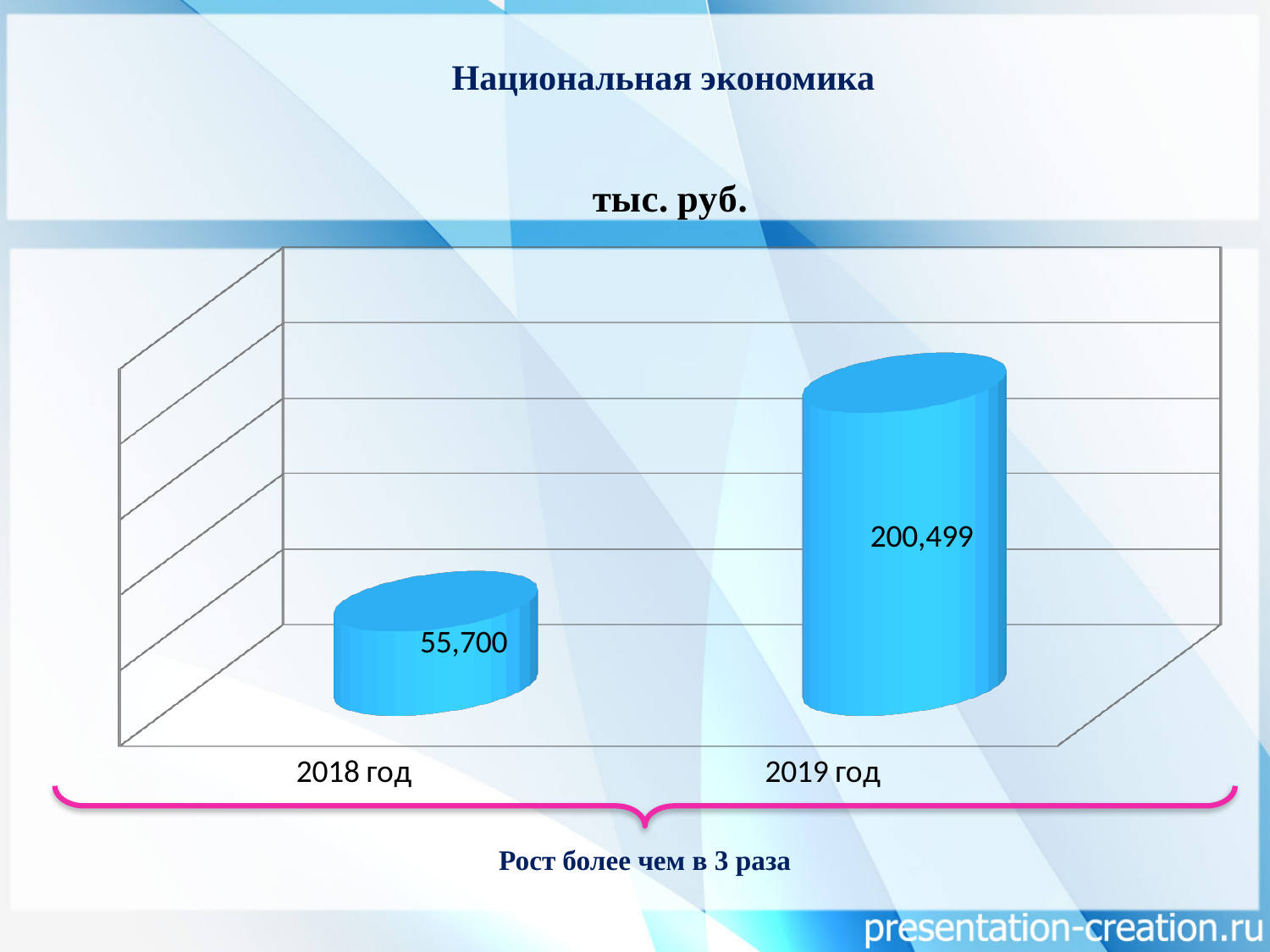
How many categories are shown on the chart? 2 What is the title of the chart? тыс. руб. Which year has the highest value? 2019 год What is the difference between the values for 2019 год and 2018 год? 144,799 Do the values rise or fall from 2018 год to 2019 год? Rise Which year has the lowest value? 2018 год What is the value for 2018 год? 55,700 What text is written under the bracket below the chart? Рост более чем в 3 раза What is the value for 2019 год? 200,499 Which is larger, the value for 2018 год or the value for 2019 год? 2019 год What kind of chart is shown on the slide? Bar chart